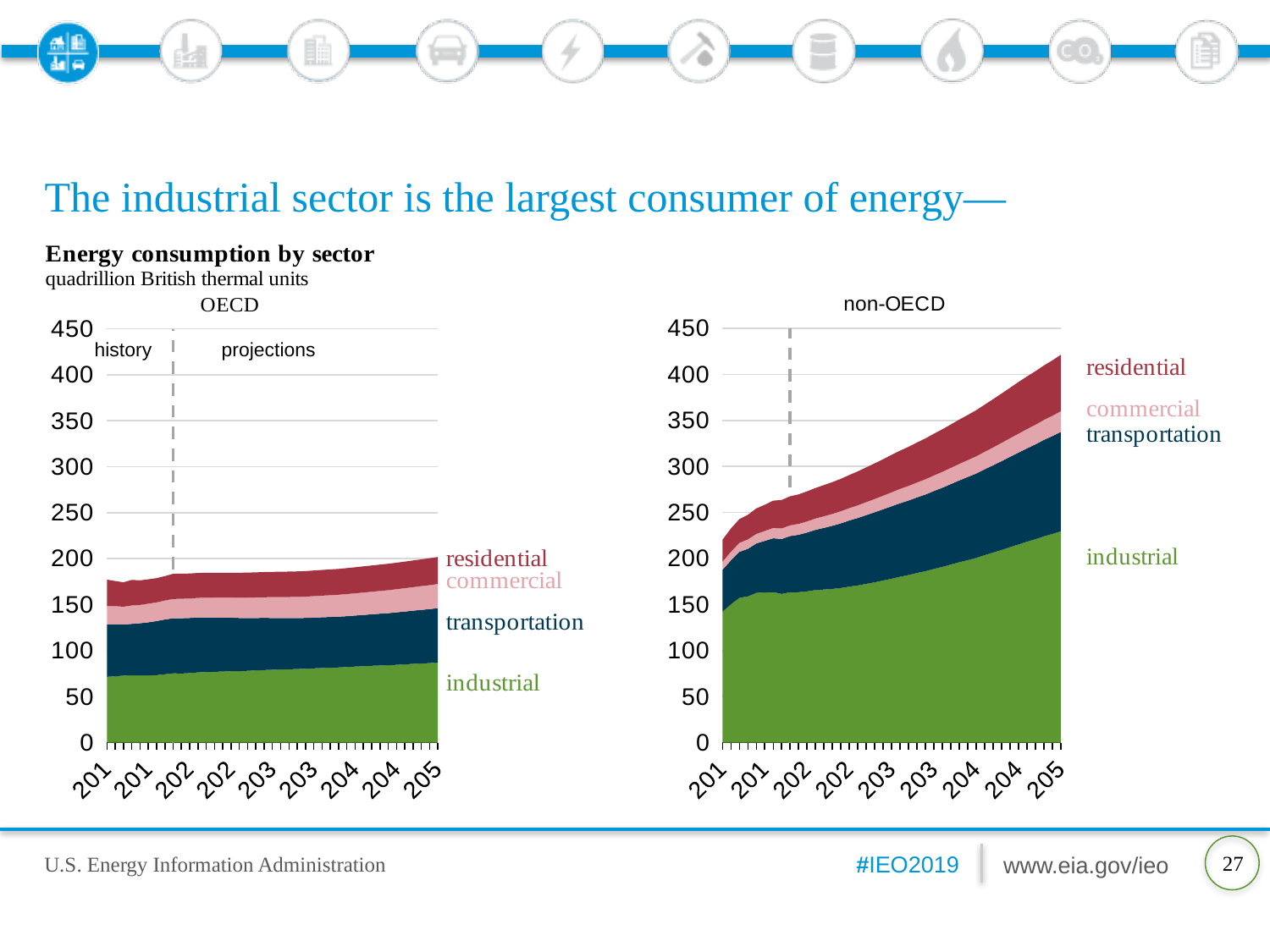
In the non-OECD chart, is industrial energy consumption at the end of the projection period greater or less than 200? greater In the non-OECD chart, which sector is the largest consumer of energy? industrial In the OECD chart, is industrial energy consumption at the end of the projection period greater or less than 100? less What unit is energy consumption measured in on these charts? quadrillion British thermal units In the non-OECD chart, is total energy consumption at the end of the projection period greater or less than 400? greater In the OECD chart, which sector is the smallest consumer of energy? commercial What kind of chart is the OECD chart? stacked area chart In the non-OECD chart, does total energy consumption rise or fall over the projection period? rise How many sectors (series) are shown in the non-OECD chart? 4 At the end of the projection period, which region has higher total energy consumption, OECD or non-OECD? non-OECD What is the title of the charts on the slide? Energy consumption by sector